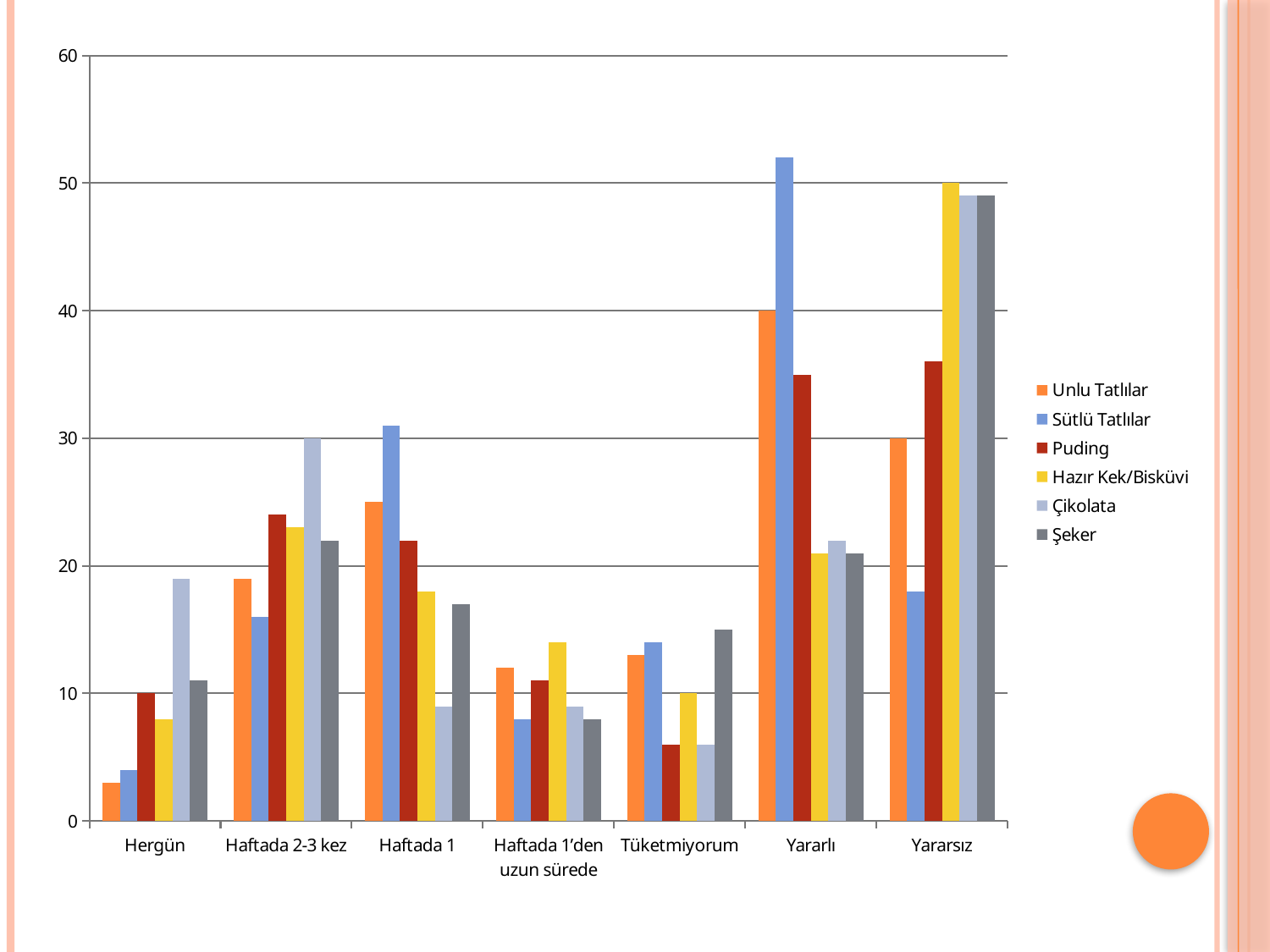
Which series is shown in yellow in the legend? Hazır Kek/Bisküvi How many categories are shown on the x axis? 7 Which is larger in the Yararsız category, Unlu Tatlılar or Sütlü Tatlılar? Unlu Tatlılar Is the value for Sütlü Tatlılar in the Yararlı category greater or less than 50? greater Which is larger in the Haftada 1 category, Sütlü Tatlılar or Çikolata? Sütlü Tatlılar Which series has the lowest value in the Hergün category? Unlu Tatlılar Is the value for Şeker in the Yararsız category greater or less than 40? greater What kind of chart is shown on the slide? bar chart Is the value for Puding in the Tüketmiyorum category greater or less than 10? less How many series does the legend list? 6 Which series has the highest value in the Haftada 2-3 kez category? Çikolata Which series has the highest value in the Yararlı category? Sütlü Tatlılar